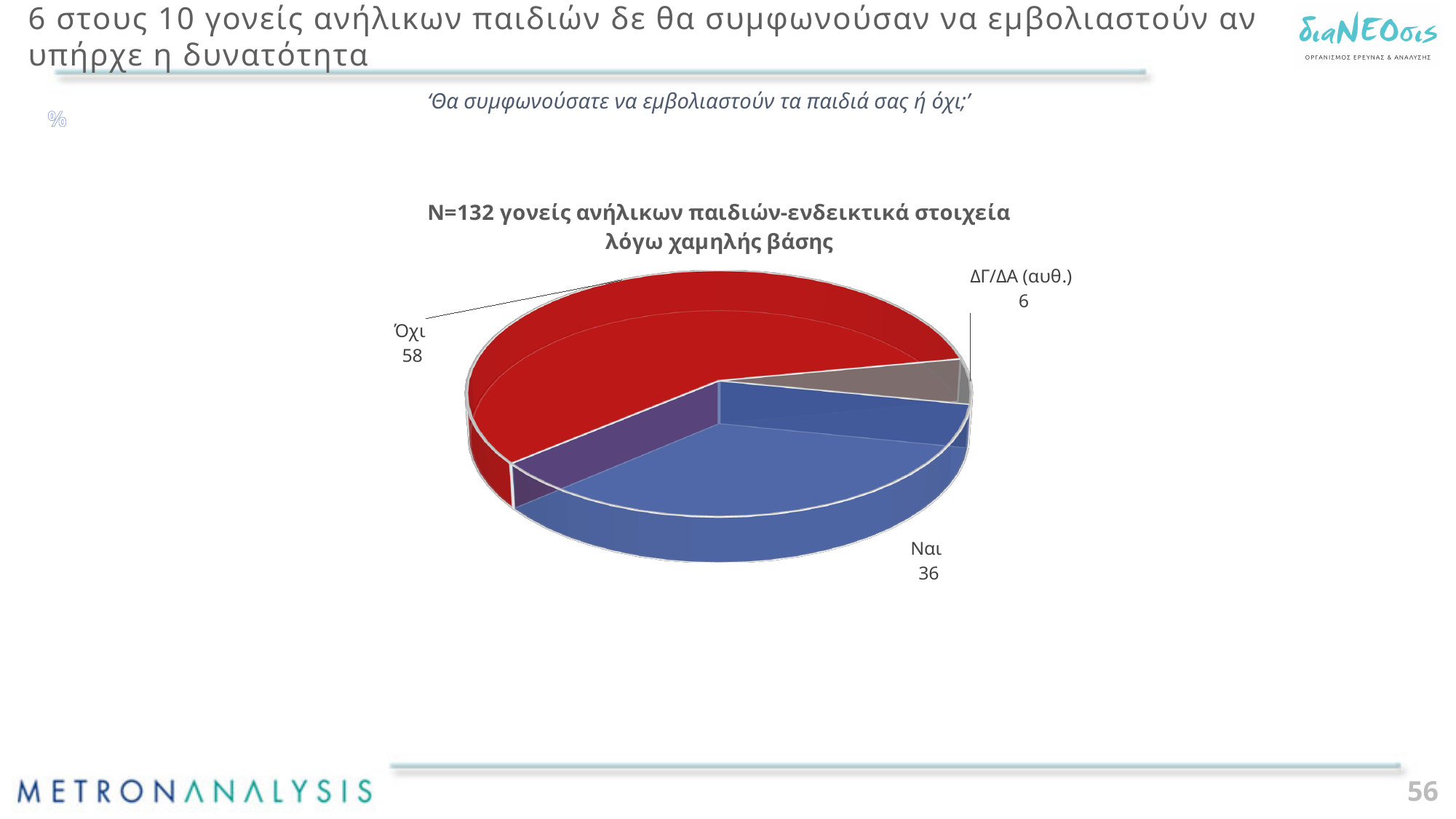
Which category has the smallest slice in the pie chart? ΔΓ/ΔΑ (αυθ.) What type of chart is shown on the slide? Pie chart What colour is the Όχι slice in the pie chart? Red Which is larger, the value for Ναι or the value for Όχι? Όχι How many slices does the pie chart have? 3 What is the sample size (N) stated in the chart title? 132 Which category has the largest slice in the pie chart? Όχι What is the difference between the values for Όχι and Ναι? 22 What is the value for Ναι in the pie chart? 36 What is the difference between the values for Ναι and ΔΓ/ΔΑ (αυθ.)? 30 What is the value for Όχι in the pie chart? 58 What is the value for ΔΓ/ΔΑ (αυθ.) in the pie chart? 6